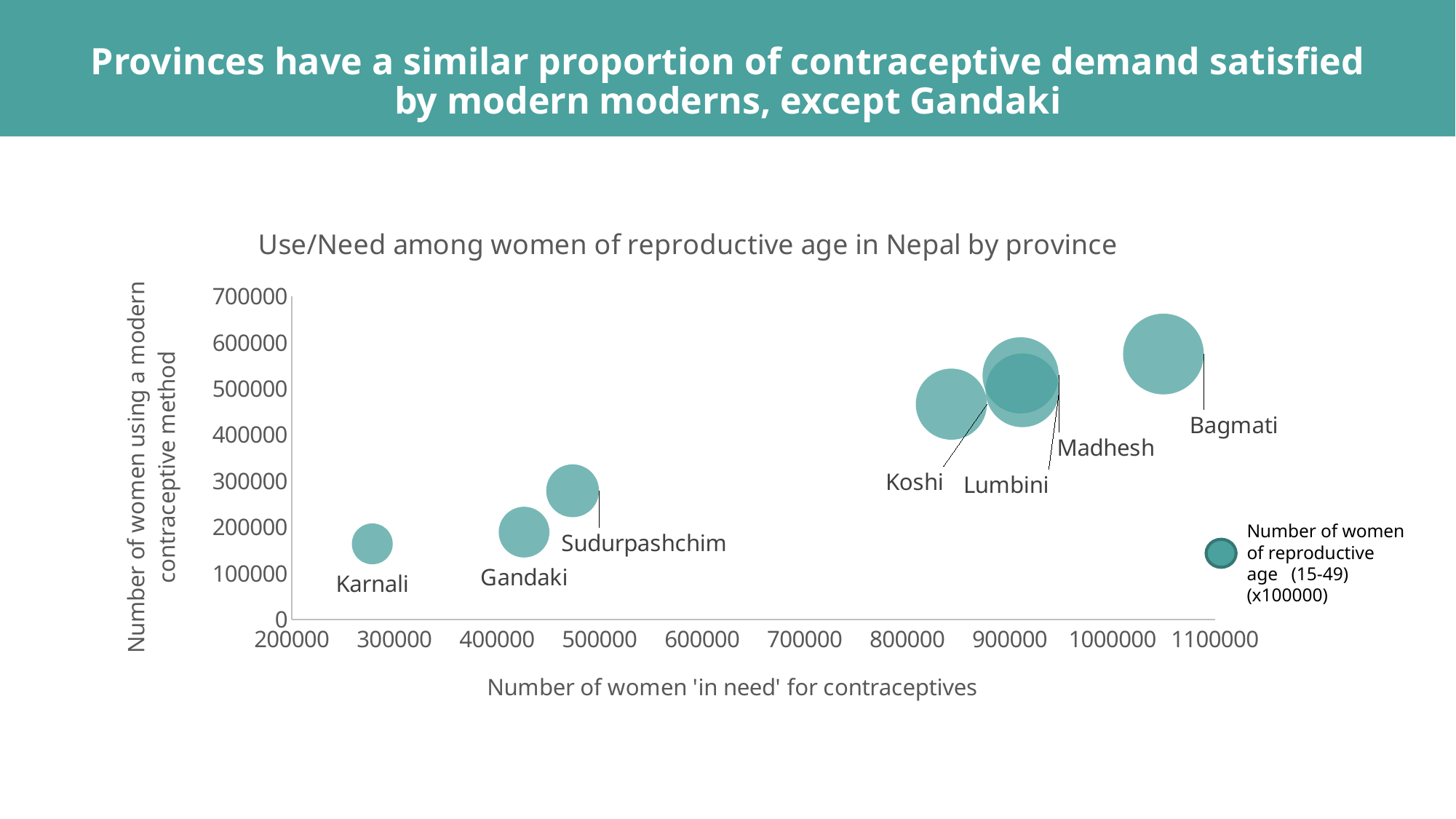
What does the bubble size represent according to the legend? Number of women of reproductive age (15-49) (x100000) What is the title of the chart? Use/Need among women of reproductive age in Nepal by province Which province has the lowest number of women 'in need' for contraceptives? Karnali Is the number of women 'in need' for contraceptives for Bagmati greater or less than 1000000? greater Which province has more women using a modern contraceptive method, Sudurpashchim or Gandaki? Sudurpashchim Do the numbers of women using a modern contraceptive method generally rise or fall as the number of women 'in need' increases along the x axis? rise How many provinces are plotted in the chart? 7 What kind of chart is shown on the slide? Bubble chart Is the number of women using a modern contraceptive method for Bagmati greater or less than 500000? greater Is the number of women using a modern contraceptive method for Karnali greater or less than 200000? less Which province has the highest number of women using a modern contraceptive method? Bagmati